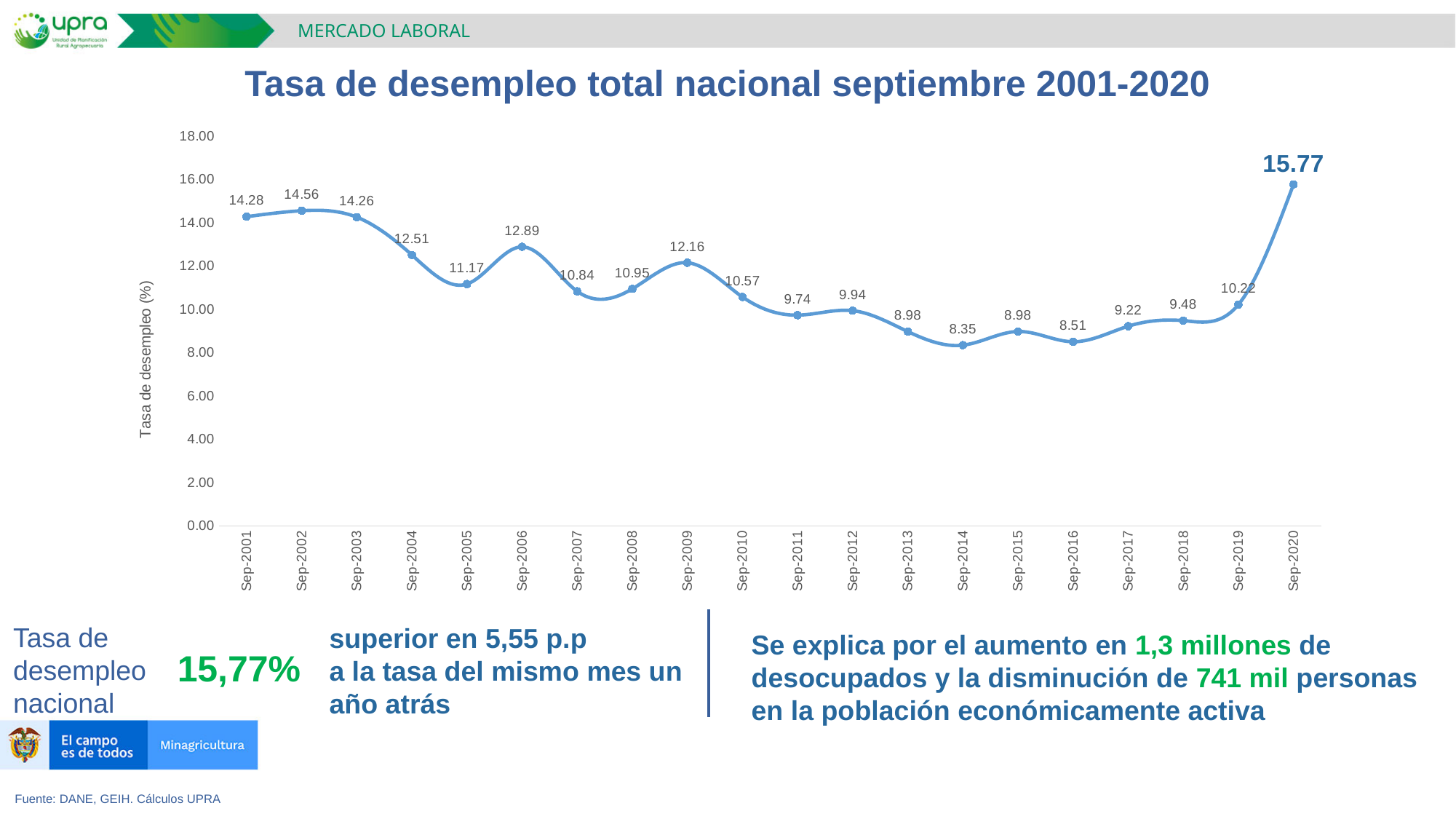
What type of chart is shown? line chart Which year has the lowest unemployment rate? Sep-2014 Is the unemployment rate for Sep-2016 greater or less than 10.00? less Which is larger, the unemployment rate in Sep-2009 or Sep-2010? Sep-2009 What is the difference between the unemployment rate in Sep-2020 and Sep-2019? 5.55 How many data points are plotted on the chart? 20 What is the label of the y axis? Tasa de desempleo (%) What is the unemployment rate for Sep-2014? 8.35 What is the unemployment rate for Sep-2020? 15.77 Does the unemployment rate rise or fall from Sep-2001 to Sep-2005? fall Which year has the highest unemployment rate? Sep-2020 What is the unemployment rate for Sep-2006? 12.89